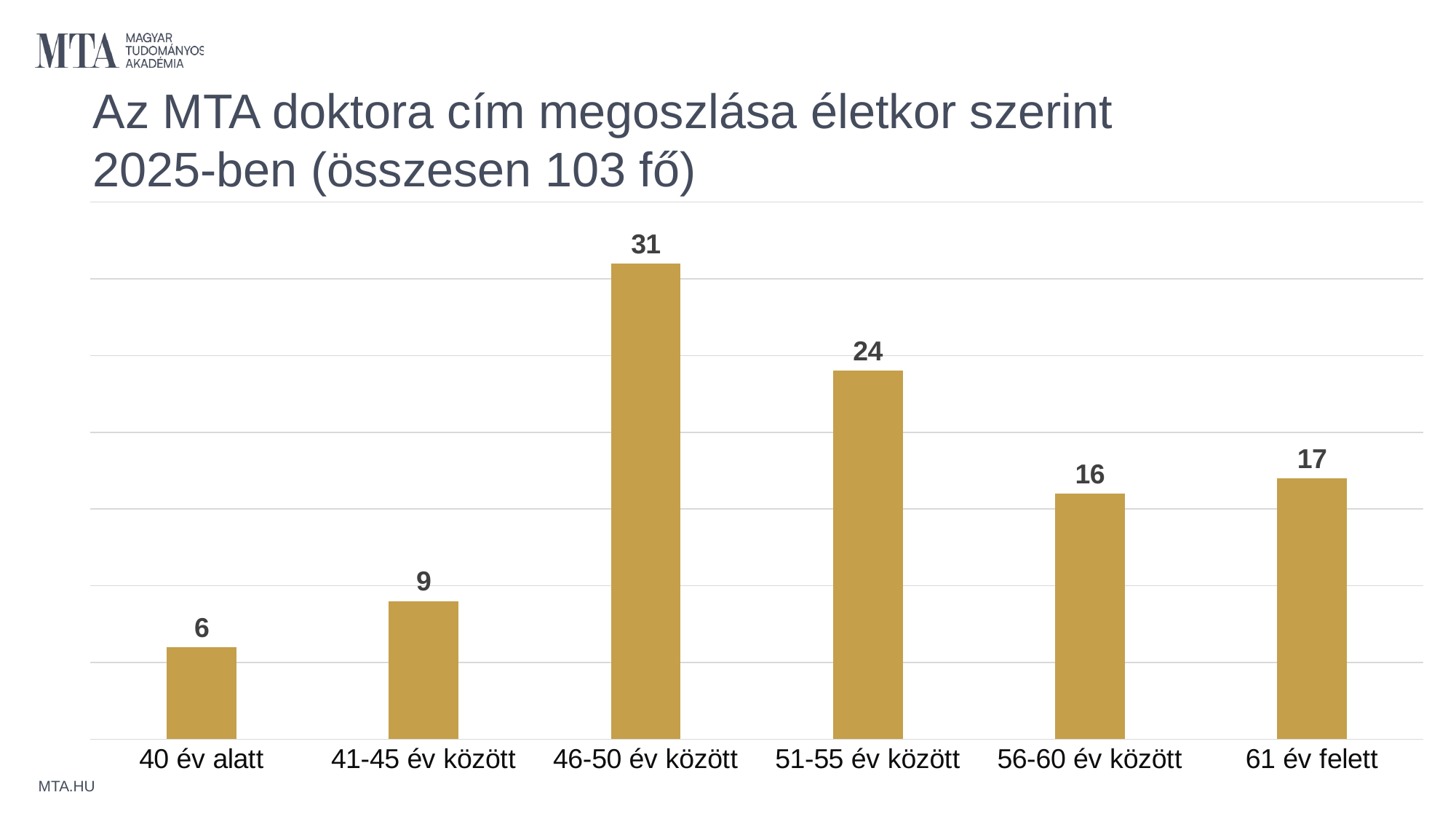
What colour are the bars in the chart? gold What kind of chart is shown on the slide? bar chart What is the value for the "46-50 év között" category? 31 How many categories are shown on the x axis? 6 What is the difference between the values for "46-50 év között" and "51-55 év között"? 7 What is the value for the "40 év alatt" category? 6 Which is larger, the value for "41-45 év között" or the value for "56-60 év között"? 56-60 év között What is the value for the "61 év felett" category? 17 Which category has the highest value? 46-50 év között Which category has the lowest value? 40 év alatt What is the difference between the values for "61 év felett" and "56-60 év között"? 1 What is the title of the chart on the slide? Az MTA doktora cím megoszlása életkor szerint 2025-ben (összesen 103 fő)